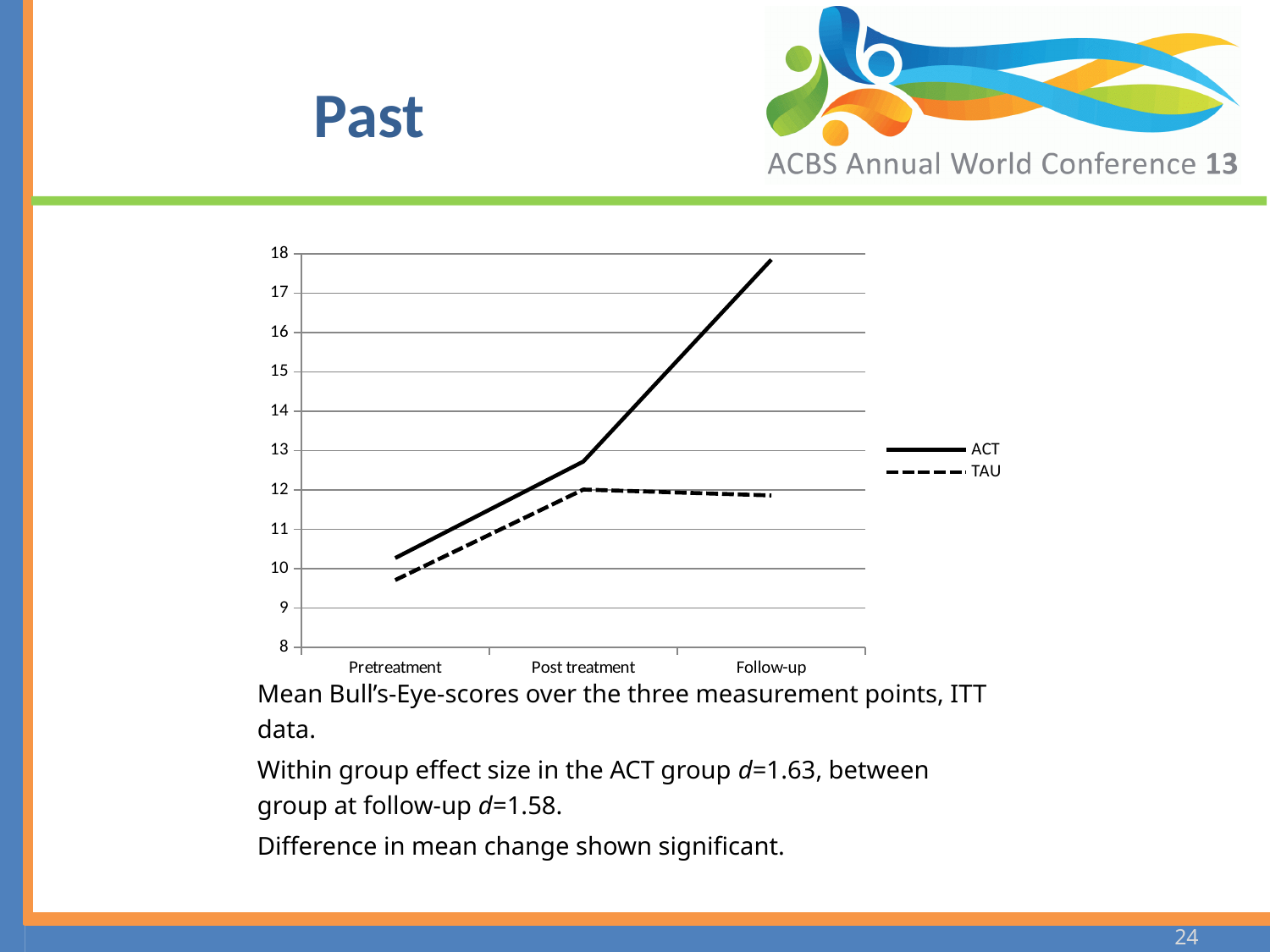
Is the ACT value at Follow-up greater or less than 17? greater How many series does the legend list? 2 At which measurement point is the ACT score highest? Follow-up Is the ACT value at Pretreatment greater or less than 11? less At Pretreatment, which group has the higher score, ACT or TAU? ACT How many measurement points are shown on the x axis? 3 Which series is drawn with a dashed line? TAU At Follow-up, which group has the higher score, ACT or TAU? ACT Is the TAU value at Follow-up greater or less than 13? less What kind of chart is shown on the slide? Line chart Does the ACT line rise or fall from Pretreatment to Follow-up? Rise